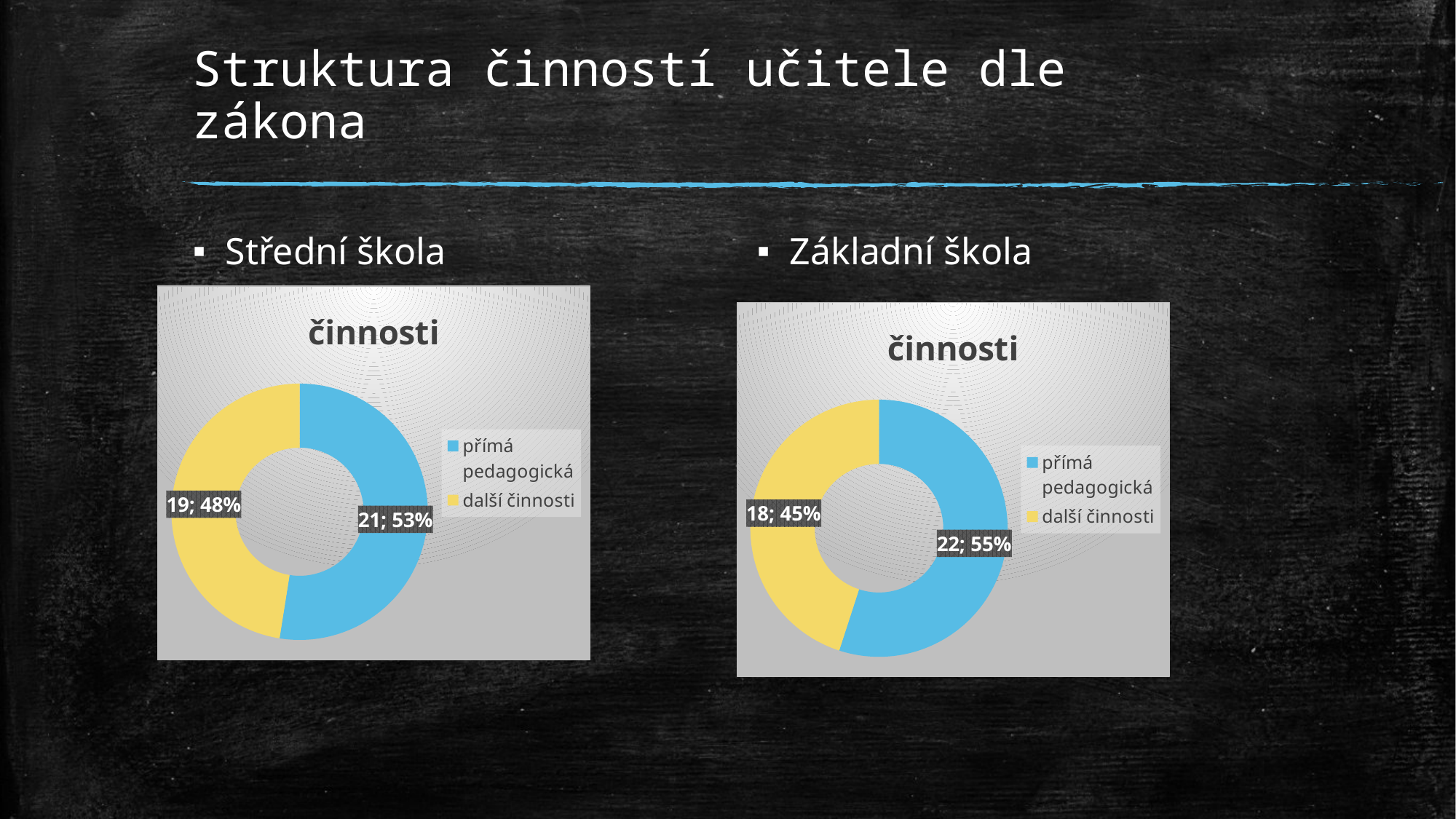
In the Základní škola chart, what value is shown for další činnosti? 18; 45% How many categories does the Základní škola chart show? 2 In the Střední škola chart, what value is shown for přímá pedagogická? 21; 53% In the Základní škola chart, what is the difference between the přímá pedagogická and další činnosti values? 4 In the Střední škola chart, which category is the smallest? další činnosti In the Střední škola chart, what share of the pie does přímá pedagogická take? 53% What type of chart is used on the left (Střední škola)? Doughnut chart In the Základní škola chart, what share of the pie does další činnosti take? 45% In the Základní škola chart, which category is the largest? přímá pedagogická What is the title of the Střední škola chart? činnosti In the Základní škola chart, what value is shown for přímá pedagogická? 22; 55% In the Střední škola chart, what value is shown for další činnosti? 19; 48%